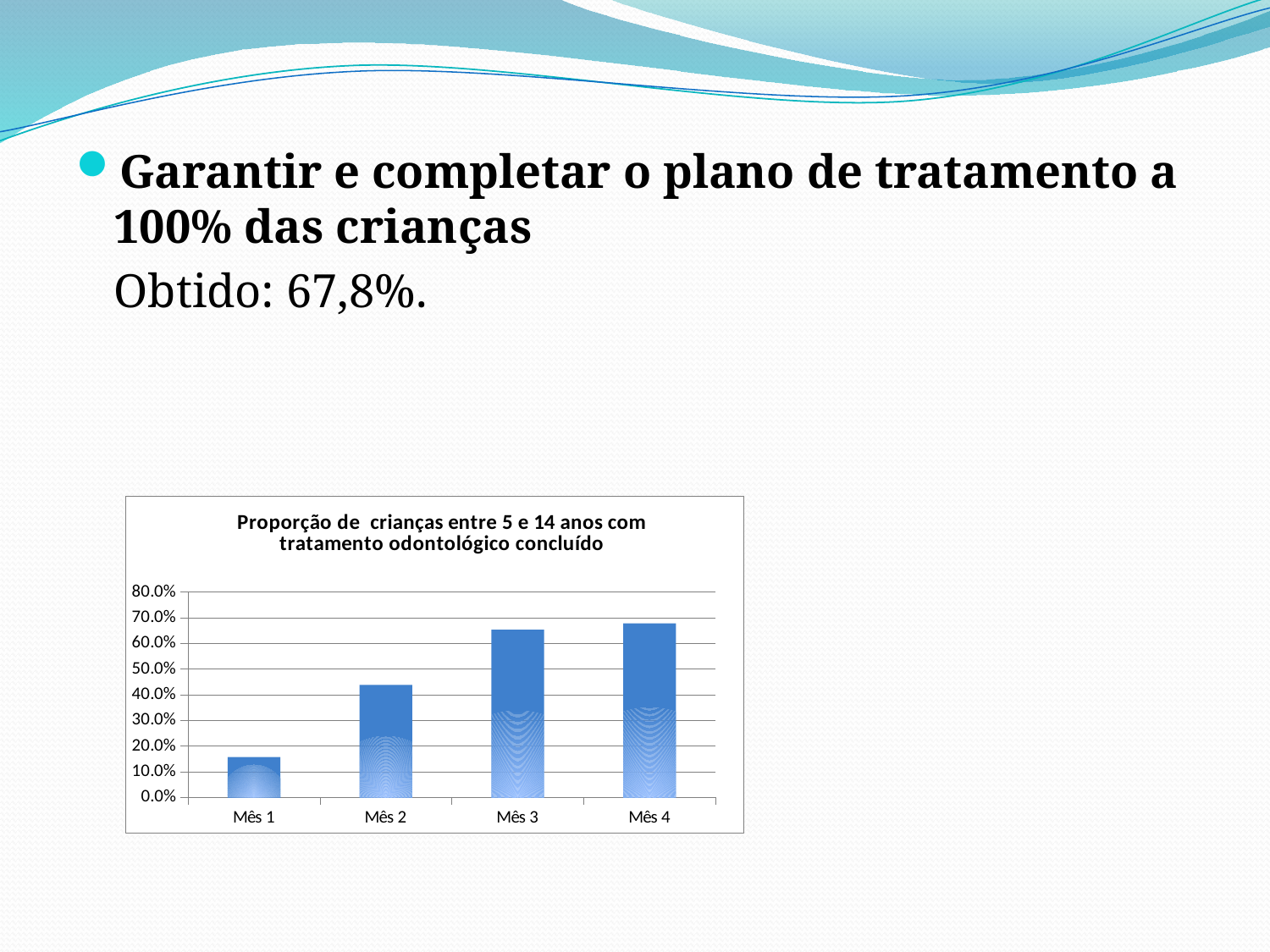
Which month has the lowest proportion of children with completed dental treatment? Mês 1 What is the title of the chart? Proporção de crianças entre 5 e 14 anos com tratamento odontológico concluído What is the highest value shown on the chart's vertical axis? 80.0% Is the value for Mês 2 greater or less than 40.0%? greater How many categories (months) are plotted on the chart? 4 What kind of chart is shown on the slide? bar chart Is the value for Mês 1 greater or less than 20.0%? less Is the value for Mês 2 greater or less than 50.0%? less Which is larger, the value for Mês 2 or the value for Mês 3? Mês 3 Do the values rise or fall from Mês 1 to Mês 4? rise